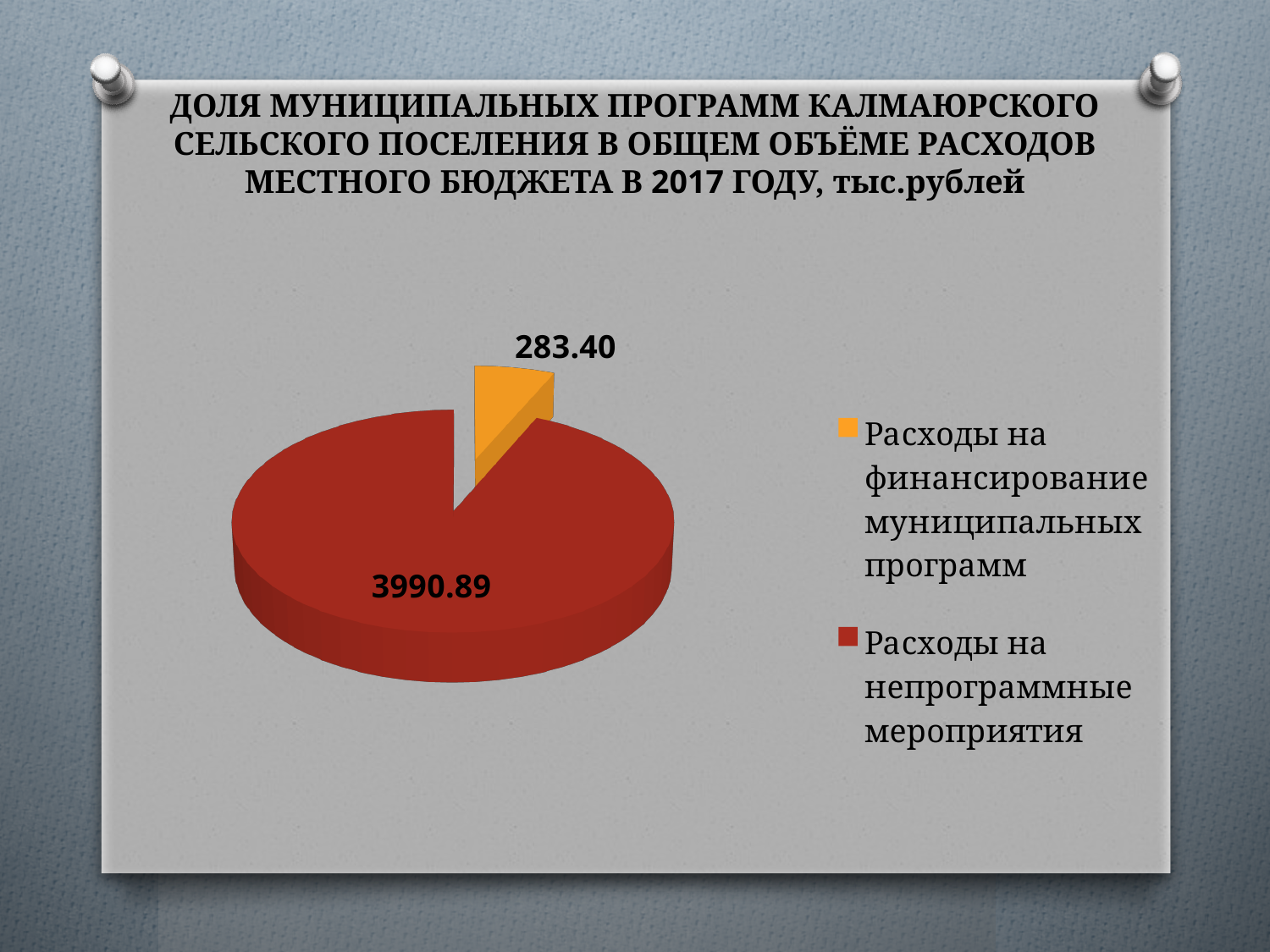
Which category has the largest slice of the pie? Расходы на непрограммные мероприятия What type of chart is shown on the slide? Pie chart How many entries does the legend list? 2 How many slices does the pie chart have? 2 What is the total of the two values shown on the pie chart? 4274.29 What is the value for "Расходы на непрограммные мероприятия"? 3990.89 Which is larger: the value for "Расходы на финансирование муниципальных программ" or the value for "Расходы на непрограммные мероприятия"? Расходы на непрограммные мероприятия What share of the pie does "Расходы на финансирование муниципальных программ" represent, to the nearest whole percent? 7% What is the difference between the value for "Расходы на непрограммные мероприятия" and the value for "Расходы на финансирование муниципальных программ"? 3707.49 What is the value for "Расходы на финансирование муниципальных программ"? 283.40 Which category has the smallest slice of the pie? Расходы на финансирование муниципальных программ What colour is the slice for "Расходы на непрограммные мероприятия"? Red